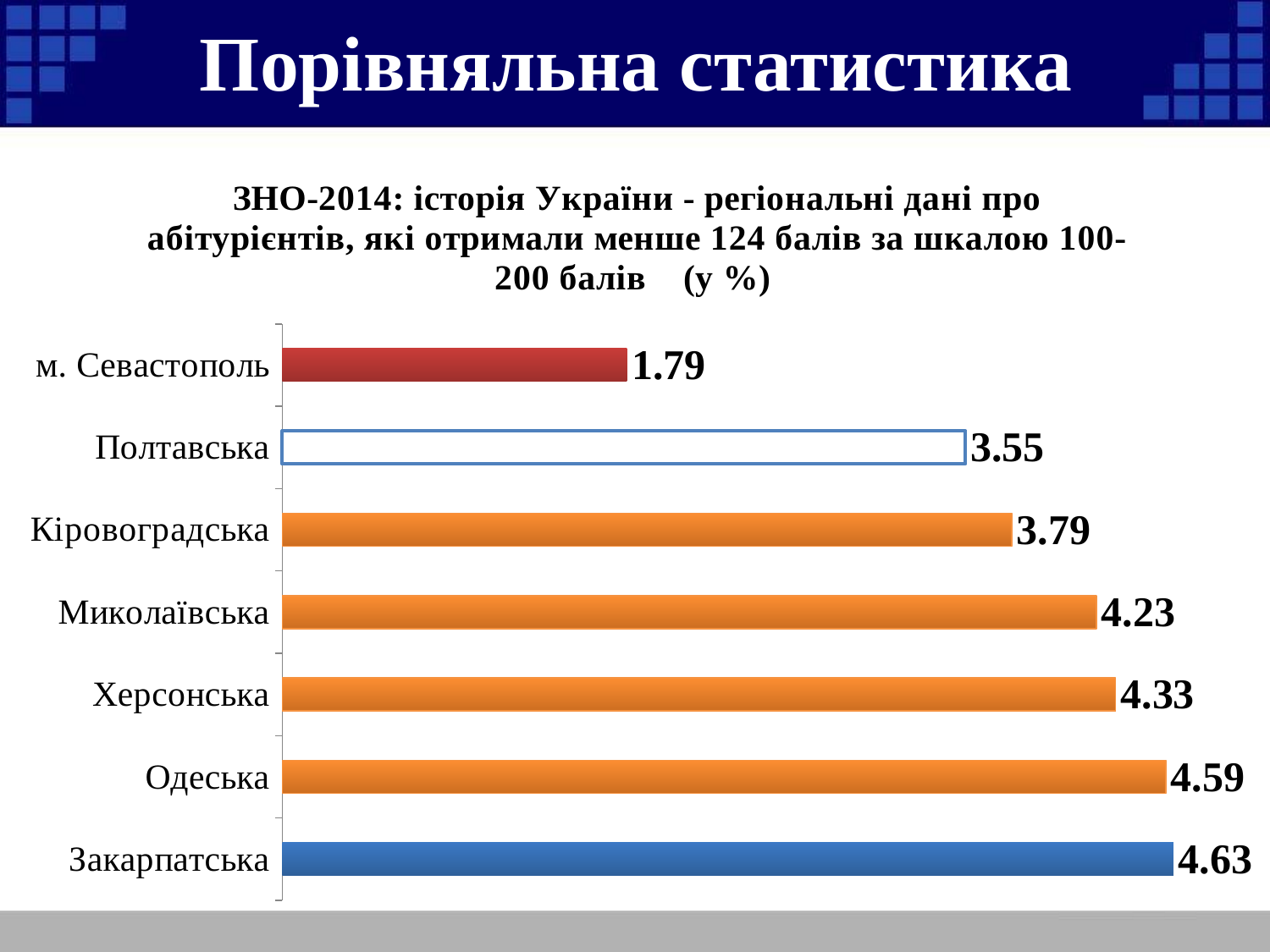
Which year's ЗНО does the chart title refer to? 2014 What colour is the bar for м. Севастополь? Red What is the value for Полтавська? 3.55 What is the value for м. Севастополь? 1.79 How many regions are shown in the chart? 7 What kind of chart is shown on the slide? Bar chart Which region has the highest value? Закарпатська What is the value for Миколаївська? 4.23 Which category has the lowest value? м. Севастополь What is the difference between the values for Закарпатська and м. Севастополь? 2.84 What is the difference between the values for Одеська and Херсонська? 0.26 Which has a larger value, Кіровоградська or Полтавська? Кіровоградська